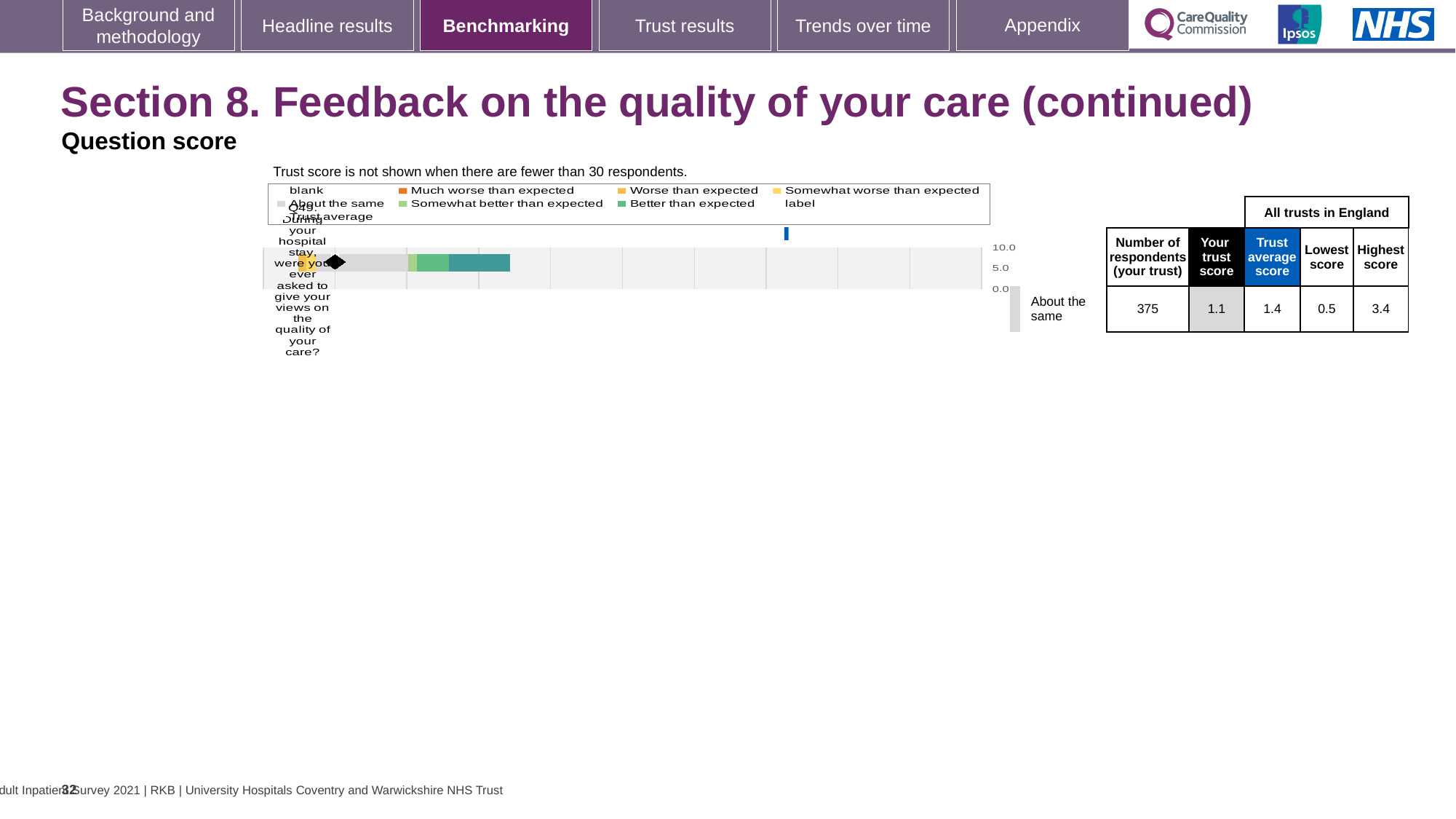
What kind of chart is shown on the slide? bar chart In the table beside the chart, what is the highest score among all trusts in England for Q49? 3.4 In the chart legend, which colour represents 'Much worse than expected'? orange In the table beside the chart, what is the number of respondents for your trust for Q49? 375 Which question is plotted in the chart? Q49. During your hospital stay, were you ever asked to give your views on the quality of your care? How many questions (categories) are plotted in the chart? 1 In the table beside the chart, what is the difference between the highest score and the lowest score for Q49? 2.9 According to the note above the chart, below how many respondents is the trust score not shown? 30 In the table beside the chart, which is larger for Q49: your trust score or the trust average score? Trust average score In the table beside the chart, what is the lowest score among all trusts in England for Q49? 0.5 In the table beside the chart, what is your trust score for Q49? 1.1 In the table beside the chart, what is the trust average score for Q49? 1.4